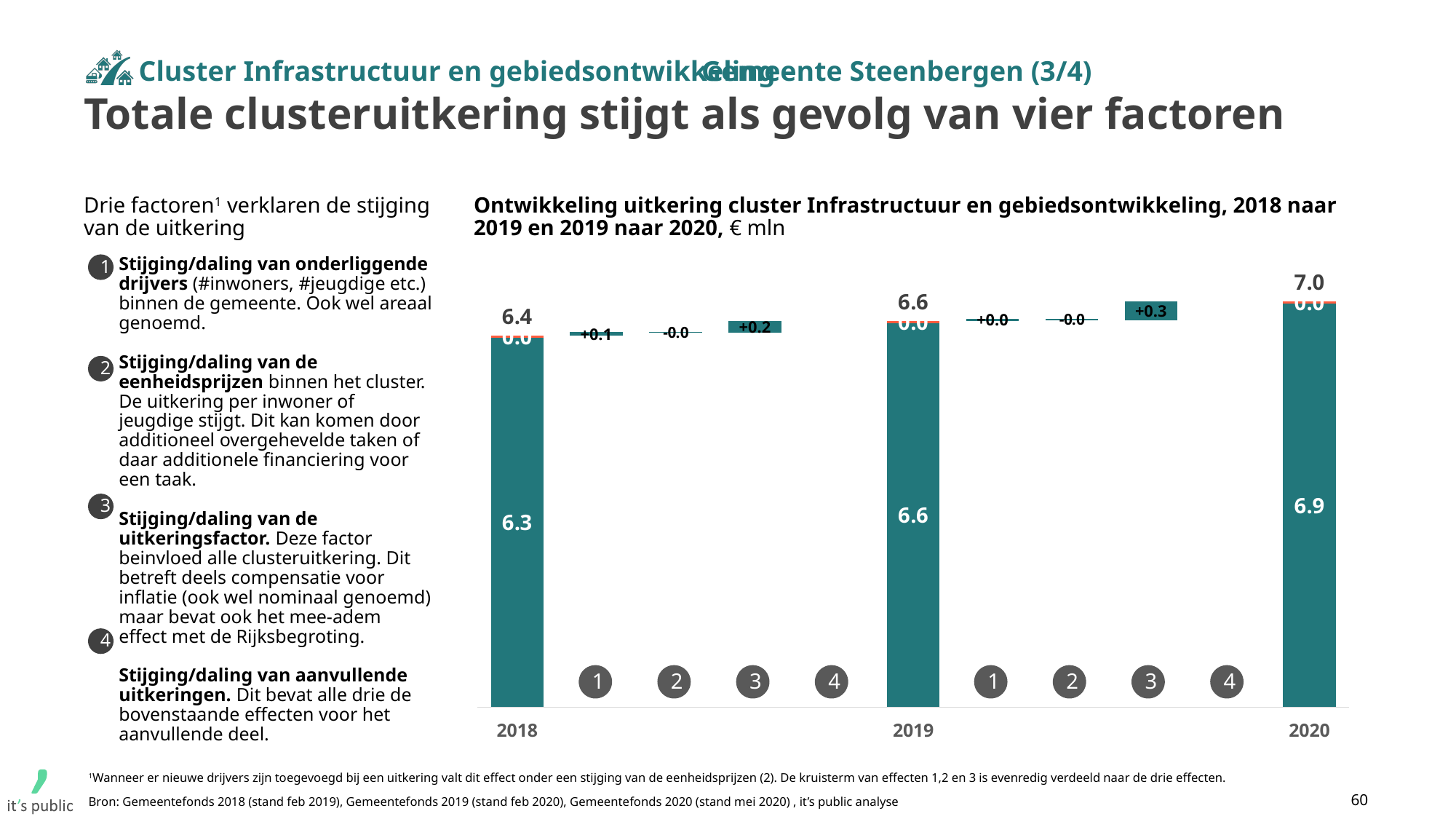
What is the total cluster payment shown for 2020? 7.0 In what unit are the values in the chart expressed? € mln What is the total cluster payment shown for 2019? 6.6 What is the effect of factor 1 on the change from 2018 to 2019? +0.1 Which year has the lowest total cluster payment? 2018 What is the effect of factor 3 on the change from 2019 to 2020? +0.3 Is the factor 3 effect larger from 2018 to 2019 or from 2019 to 2020? 2019 to 2020 Which year has the highest total cluster payment? 2020 What is the total cluster payment shown for 2018? 6.4 What is the effect of factor 3 on the change from 2018 to 2019? +0.2 What is the difference between the 2020 total and the 2018 total? 0.6 Do the total cluster payments rise or fall from 2018 to 2020? rise